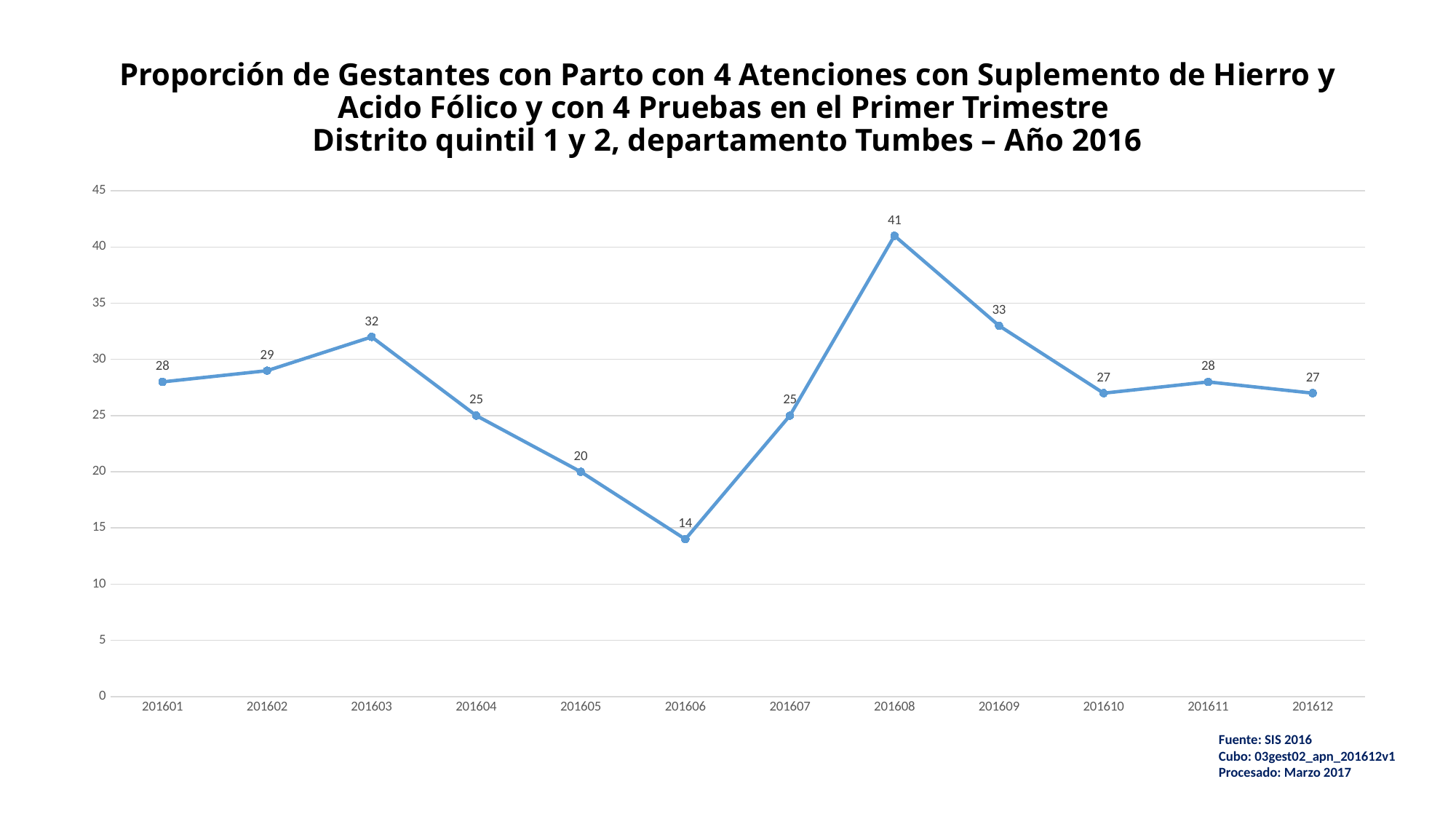
Which month has the highest value? 201608 What is the value for 201608? 41 What kind of chart is shown on the slide? Line chart Do the values rise or fall from 201603 to 201606? Fall What is the difference between the values for 201608 and 201606? 27 Which month has the lowest value? 201606 Which is larger, the value for 201603 or the value for 201604? 201603 What source is cited below the chart? SIS 2016 What is the value for 201603? 32 How many data points are plotted on the chart? 12 What is the value for 201606? 14 What is the difference between the values for 201609 and 201610? 6